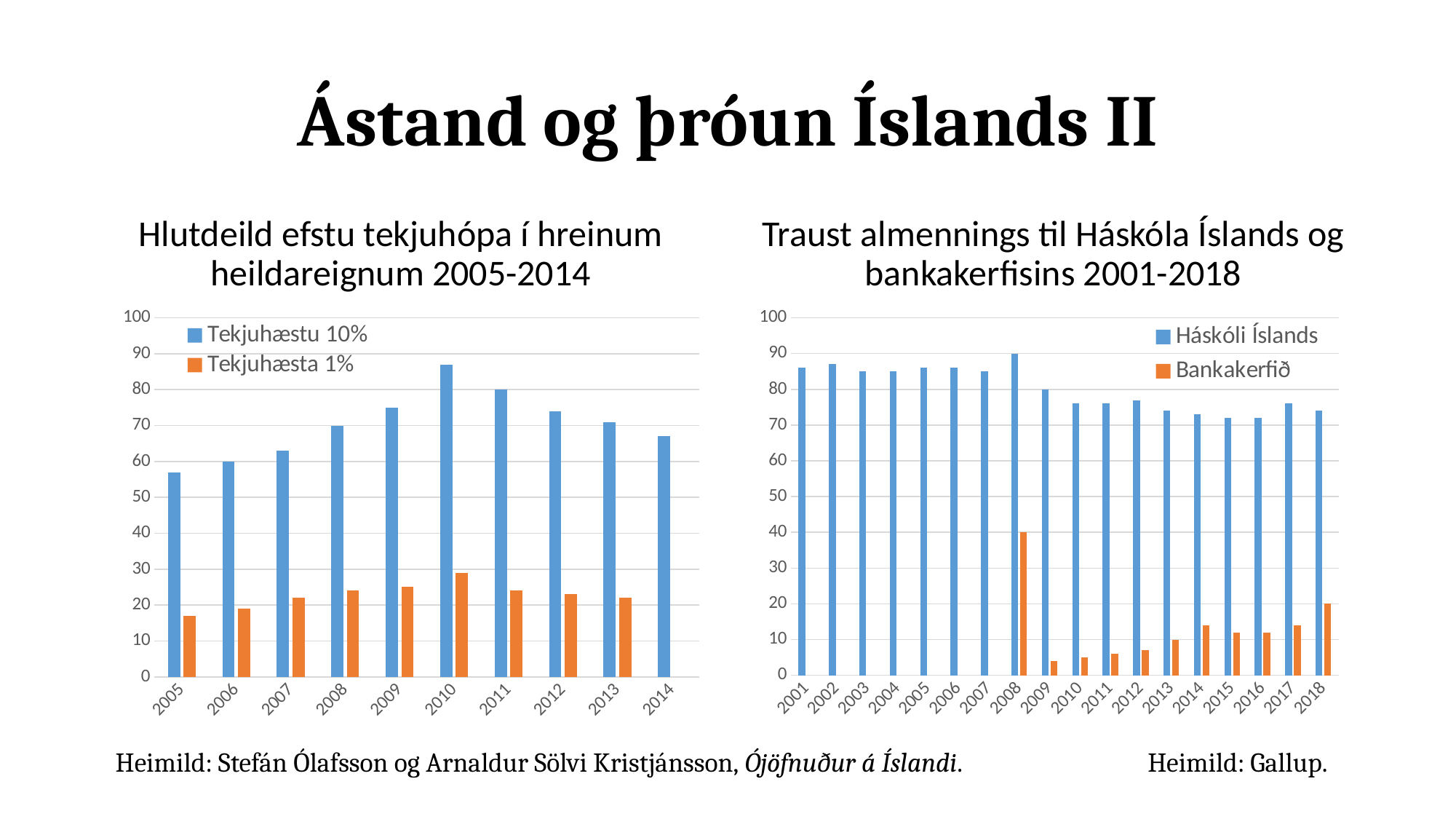
On the left chart (Hlutdeild efstu tekjuhópa), how many years are shown on the x axis? 10 On the right chart (Traust almennings), which is larger: the Háskóli Íslands value for 2008 or for 2018? 2008 On the left chart (Hlutdeild efstu tekjuhópa), how many series does the legend list? 2 On the left chart (Hlutdeild efstu tekjuhópa), in which year is the Tekjuhæstu 10% bar highest? 2010 On the right chart (Traust almennings), how many years are shown on the x axis? 18 On the right chart (Traust almennings), in which year is the Bankakerfið bar highest? 2008 On the right chart (Traust almennings), is the Bankakerfið value for 2008 greater or less than 30? greater On the left chart (Hlutdeild efstu tekjuhópa), is the Tekjuhæsta 1% value for 2005 greater or less than 20? less On the left chart (Hlutdeild efstu tekjuhópa), is the Tekjuhæstu 10% value for 2010 greater or less than 80? greater On the right chart (Traust almennings), what are the two series listed in the legend? Háskóli Íslands and Bankakerfið On the left chart (Hlutdeild efstu tekjuhópa), in which year is the Tekjuhæsta 1% bar highest? 2010 What kind of chart is the right chart (Traust almennings)? Bar chart